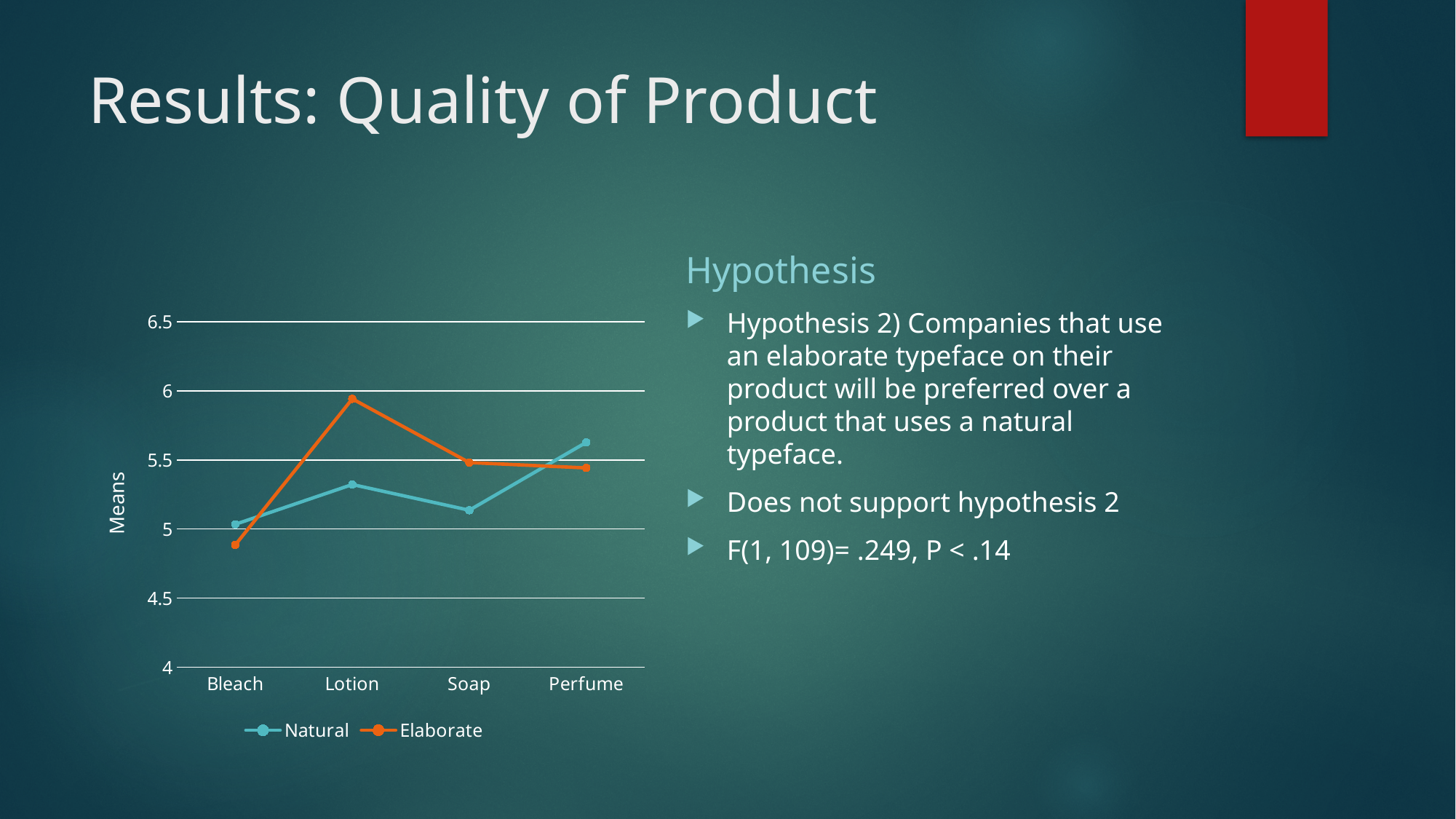
At Lotion, which series has the larger value, Natural or Elaborate? Elaborate At Perfume, which series has the larger value, Natural or Elaborate? Natural How many series does the chart legend list? 2 For which product is the Elaborate series highest? Lotion What kind of chart is shown on the slide? line chart For which product is the Natural series highest? Perfume How many product categories are shown on the x axis of the chart? 4 At Soap, which series has the larger value, Natural or Elaborate? Elaborate What is the title of the chart's vertical axis? Means Is the Elaborate value for Bleach greater or less than 5? less Is the Natural value for Perfume greater or less than 5.5? greater For which product is the Elaborate series lowest? Bleach